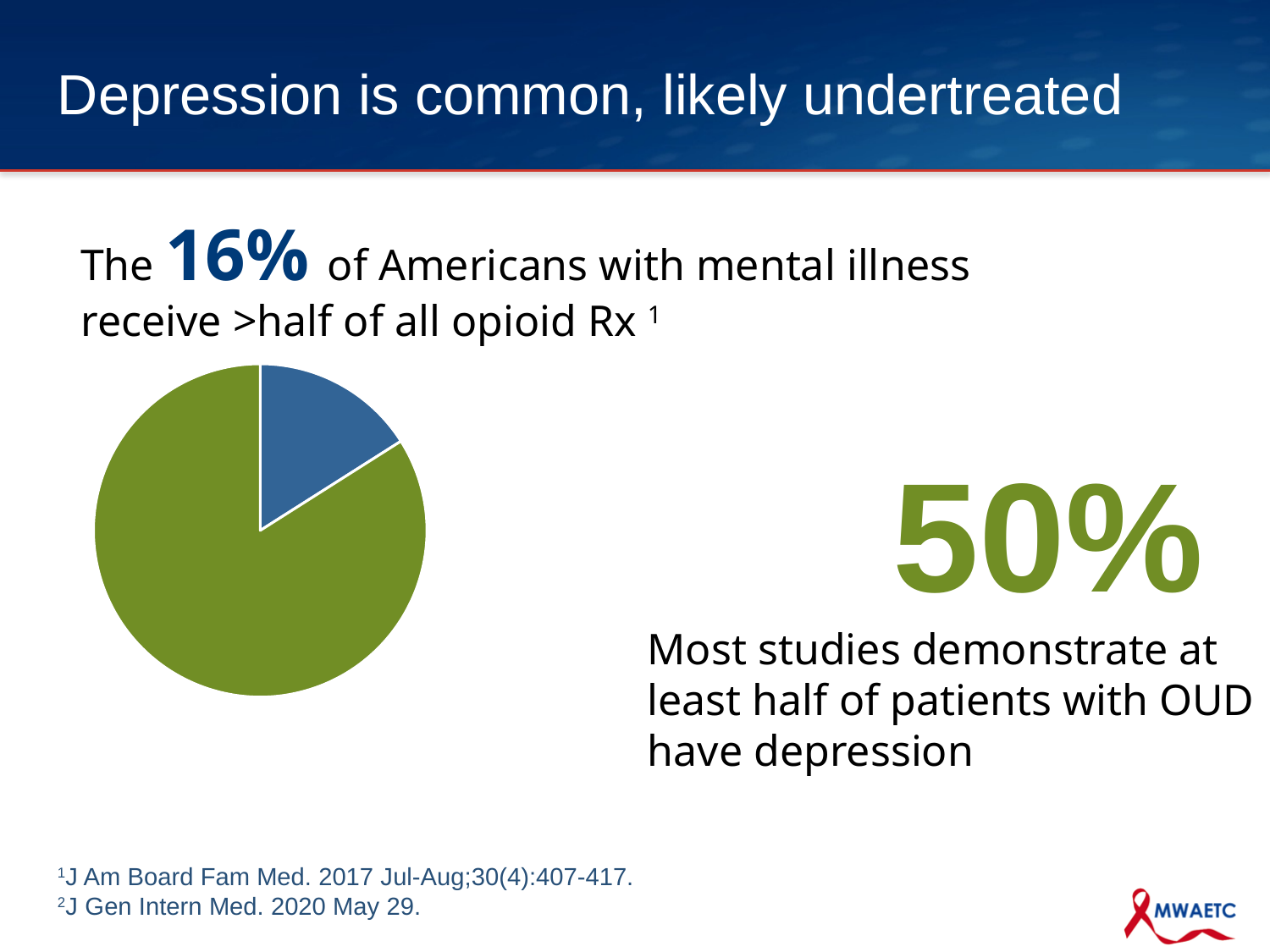
What kind of chart is shown on the slide? pie chart Is the blue slice of the pie chart greater or less than half of the pie? less Is the green slice of the pie chart greater or less than half of the pie? greater How many slices does the pie chart have? 2 Does the pie chart have a legend? No According to the slide text, what percentage does the small blue slice of the pie chart represent? 16% What two colours are used for the slices of the pie chart? blue and green Which slice of the pie chart is the smallest? the blue slice Which slice of the pie chart is larger, the blue one or the green one? green